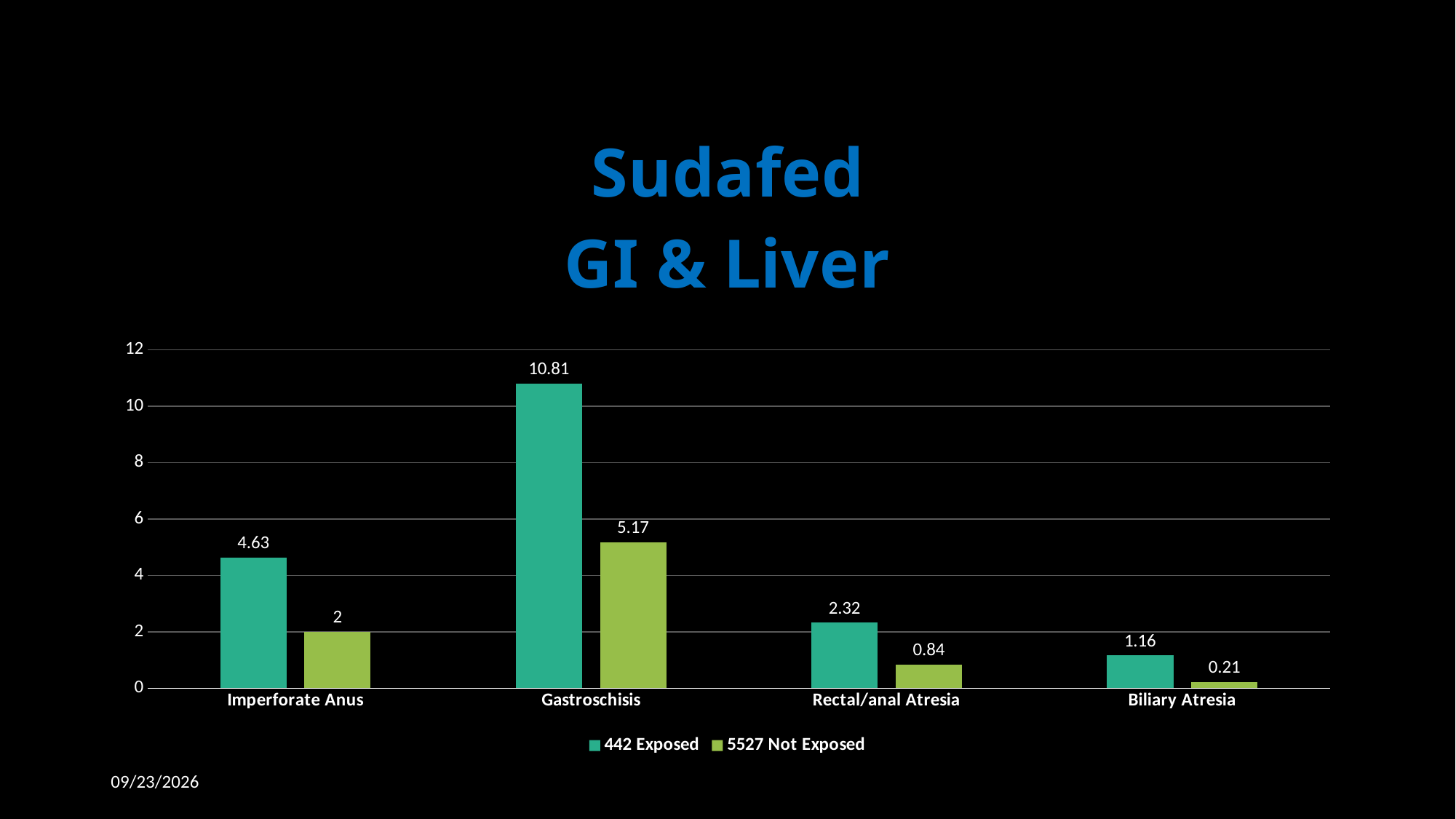
Which category has the highest value for 442 Exposed? Gastroschisis What is the value for 442 Exposed for Gastroschisis? 10.81 What is the value for 5527 Not Exposed for Imperforate Anus? 2 Which is larger for Rectal/anal Atresia: the 442 Exposed value or the 5527 Not Exposed value? 442 Exposed What is the value for 442 Exposed for Biliary Atresia? 1.16 What is the value for 5527 Not Exposed for Rectal/anal Atresia? 0.84 How many categories are shown on the x axis? 4 How many series does the legend list? 2 What kind of chart is shown on the slide? Bar chart What is the difference between the 442 Exposed and 5527 Not Exposed values for Gastroschisis? 5.64 Which category has the lowest value for 5527 Not Exposed? Biliary Atresia What is the difference between the 442 Exposed and 5527 Not Exposed values for Imperforate Anus? 2.63